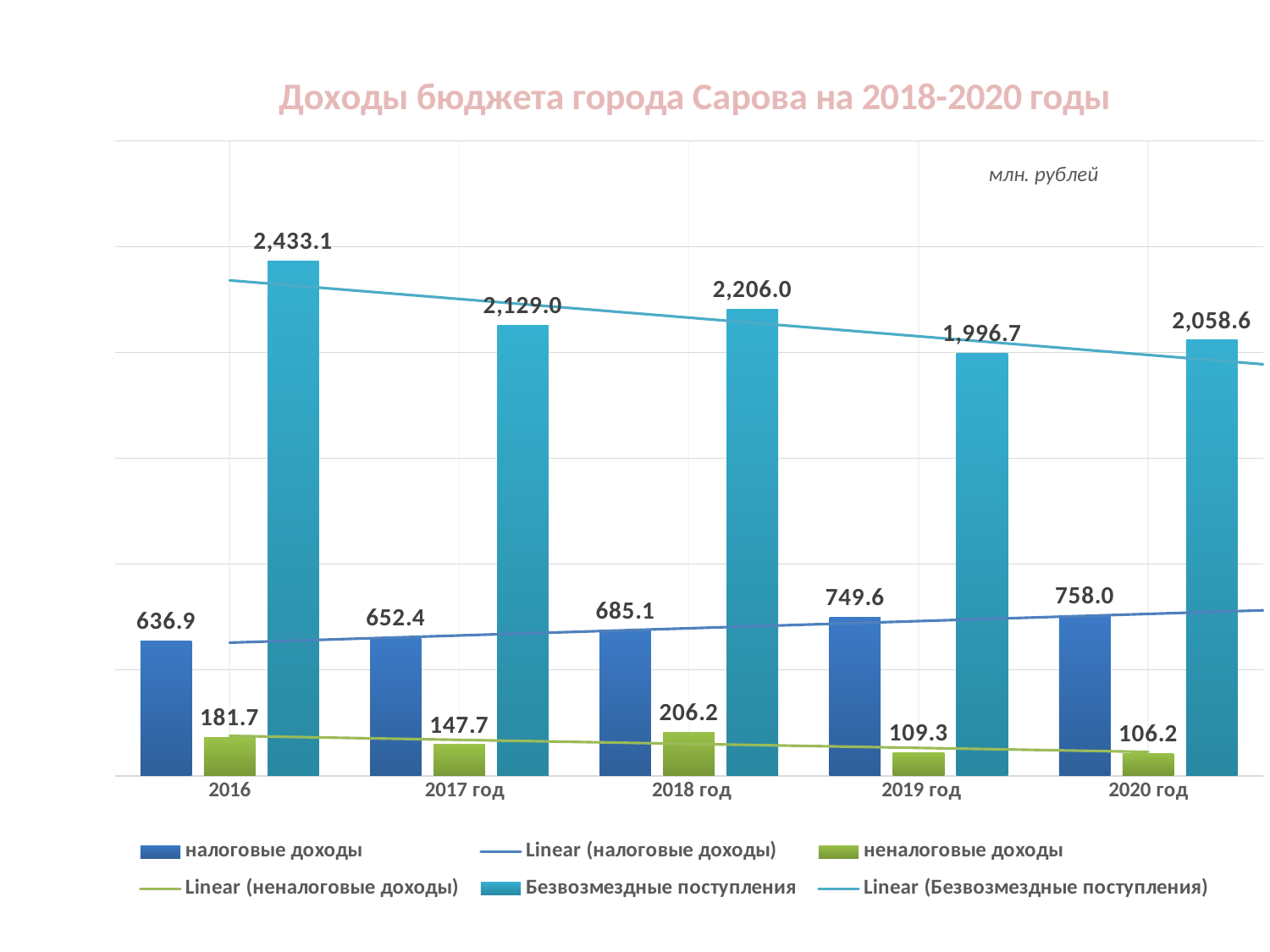
What kind of chart is this? bar chart Do the values of налоговые доходы rise or fall from 2016 to 2020 год? rise How many entries does the legend list? 6 What is the title of the chart? Доходы бюджета города Сарова на 2018-2020 годы What is the value of неналоговые доходы for 2019 год? 109.3 Which is larger: неналоговые доходы in 2018 год or in 2017 год? 2018 год What is the value of налоговые доходы for 2018 год? 685.1 In which year is налоговые доходы the highest? 2020 год What is the value of Безвозмездные поступления for 2016? 2,433.1 In which year is Безвозмездные поступления the lowest? 2019 год What is the difference between налоговые доходы in 2020 год and in 2016? 121.1 How many years are shown on the x axis? 5